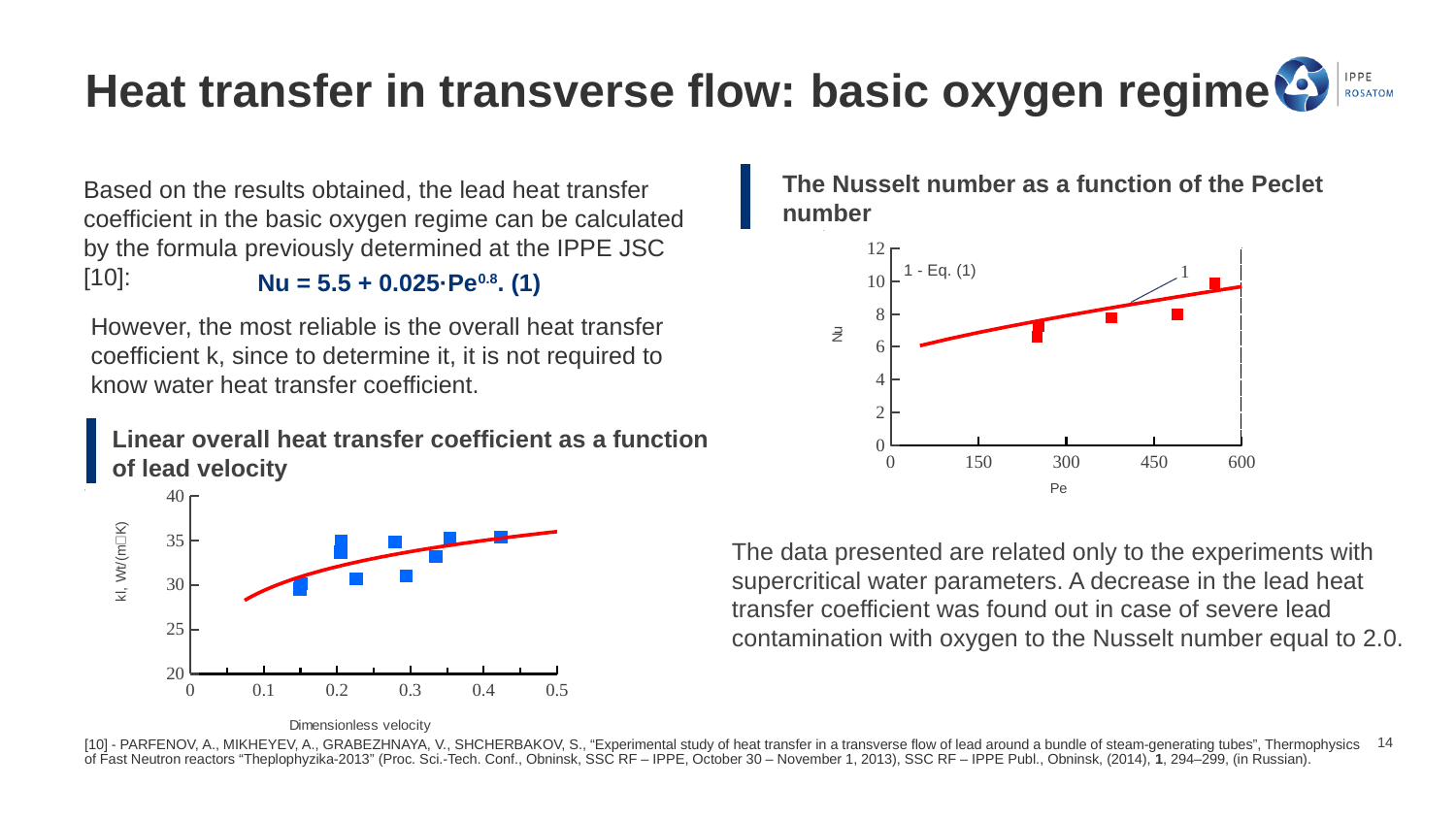
In 'The Nusselt number as a function of the Peclet number' chart, is the Nu value of the data point near Pe = 550 greater or less than 8? greater In 'The Nusselt number as a function of the Peclet number' chart, does the Nusselt number rise or fall as Pe increases along the curve? rises What kind of chart is the 'Linear overall heat transfer coefficient as a function of lead velocity' chart? scatter plot with a fitted curve What kind of chart is 'The Nusselt number as a function of the Peclet number'? scatter plot with a fitted curve In the 'Linear overall heat transfer coefficient as a function of lead velocity' chart, are all plotted data points greater or less than 25? greater What is the x-axis label of the 'Linear overall heat transfer coefficient as a function of lead velocity' chart? Dimensionless velocity In the 'Linear overall heat transfer coefficient as a function of lead velocity' chart, is the data point near dimensionless velocity 0.15 greater or less than 35? less What is the maximum value shown on the y axis of 'The Nusselt number as a function of the Peclet number' chart? 12 In 'The Nusselt number as a function of the Peclet number' chart, what does the curve labelled '1' represent according to the legend text? Eq. (1) In the 'Linear overall heat transfer coefficient as a function of lead velocity' chart, does the fitted red curve rise or fall as dimensionless velocity increases? rises